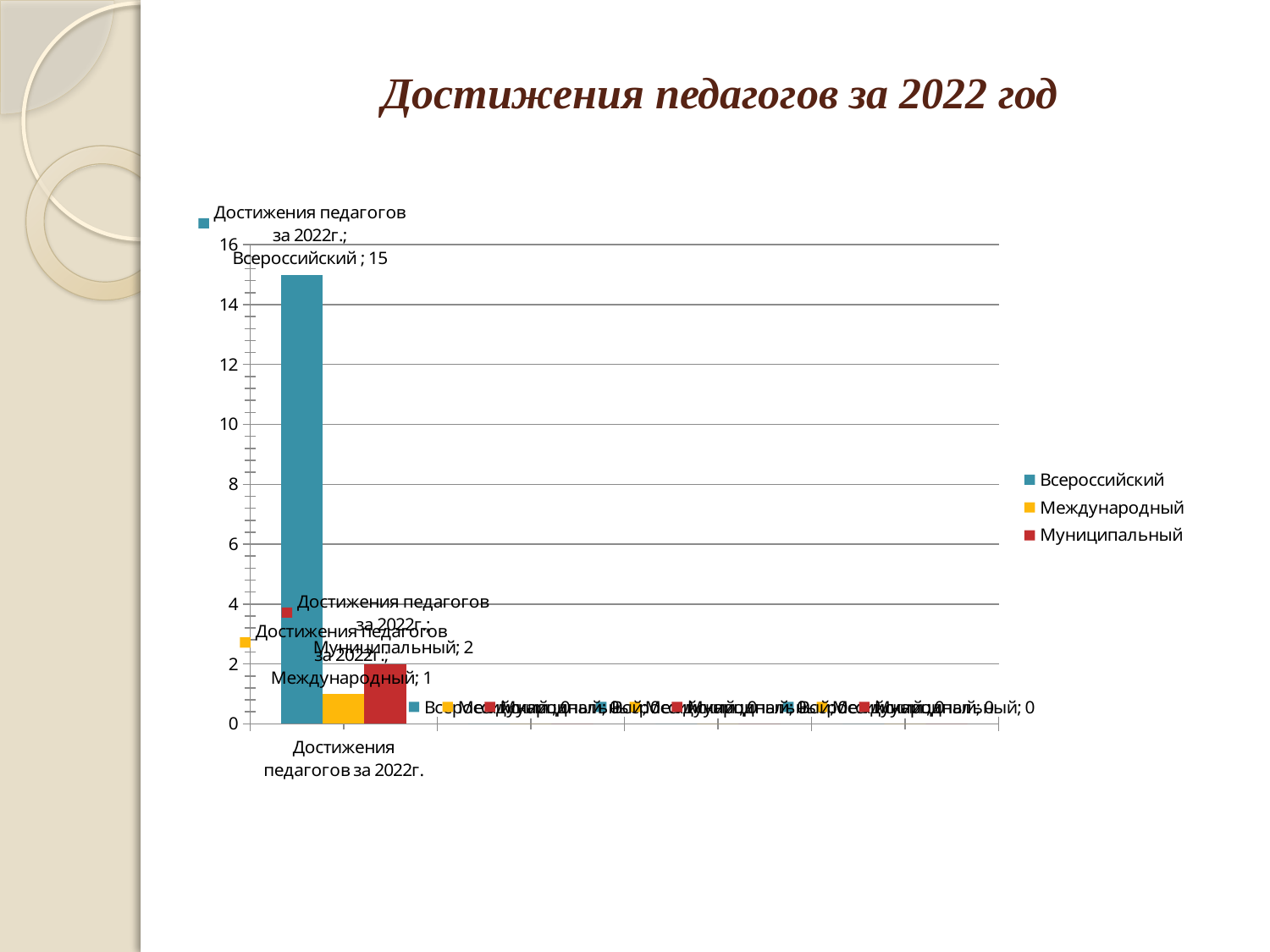
What kind of chart is shown on the slide? bar chart What is the value for Муниципальный in the chart? 2 What is the value for Всероссийский in the chart? 15 What is the value for Международный in the chart? 1 What is the title of the slide's chart? Достижения педагогов за 2022 год What is the difference between the values for Муниципальный and Международный? 1 Which series has the lowest value in the chart? Международный How many series does the legend list? 3 Which is larger, the value for Муниципальный or the value for Международный? Муниципальный Is the value for Всероссийский greater or less than 10? greater What is the difference between the values for Всероссийский and Муниципальный? 13 Which series has the highest value in the chart? Всероссийский